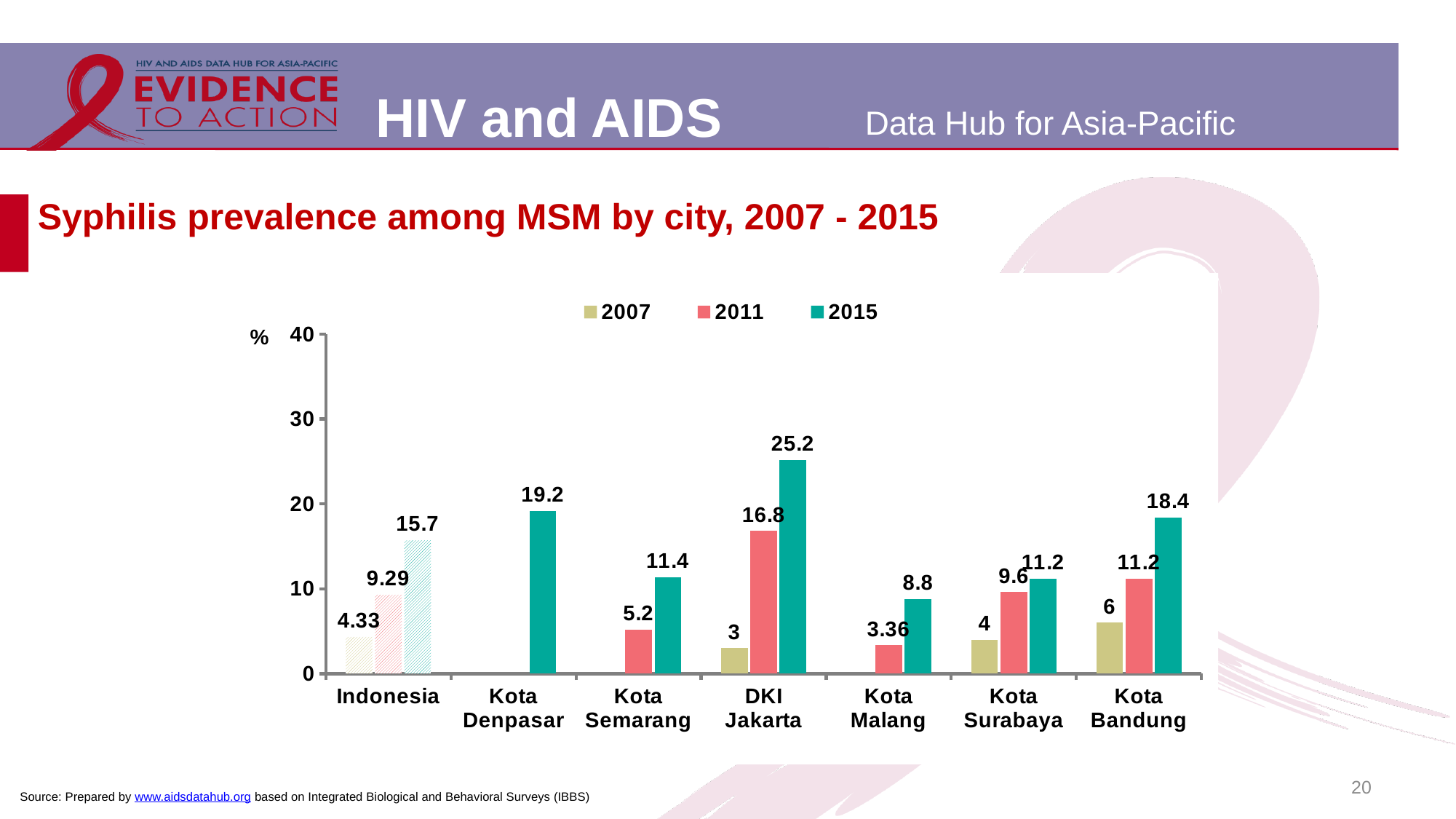
For Kota Surabaya, do the values rise or fall from 2007 to 2015? Rise What kind of chart is shown on the slide? Bar chart What is the 2015 syphilis prevalence for DKI Jakarta? 25.2 What is the 2007 value for Indonesia? 4.33 What is the 2015 value for Kota Denpasar? 19.2 Which is larger: the 2015 value for Kota Bandung or the 2015 value for Kota Denpasar? Kota Denpasar How many categories are shown on the x axis? 7 What is the 2011 value for Kota Malang? 3.36 Which category has the lowest 2011 value? Kota Malang How many series does the legend list? 3 What is the difference between the 2015 and 2011 values for DKI Jakarta? 8.4 Which city has the highest 2015 value? DKI Jakarta